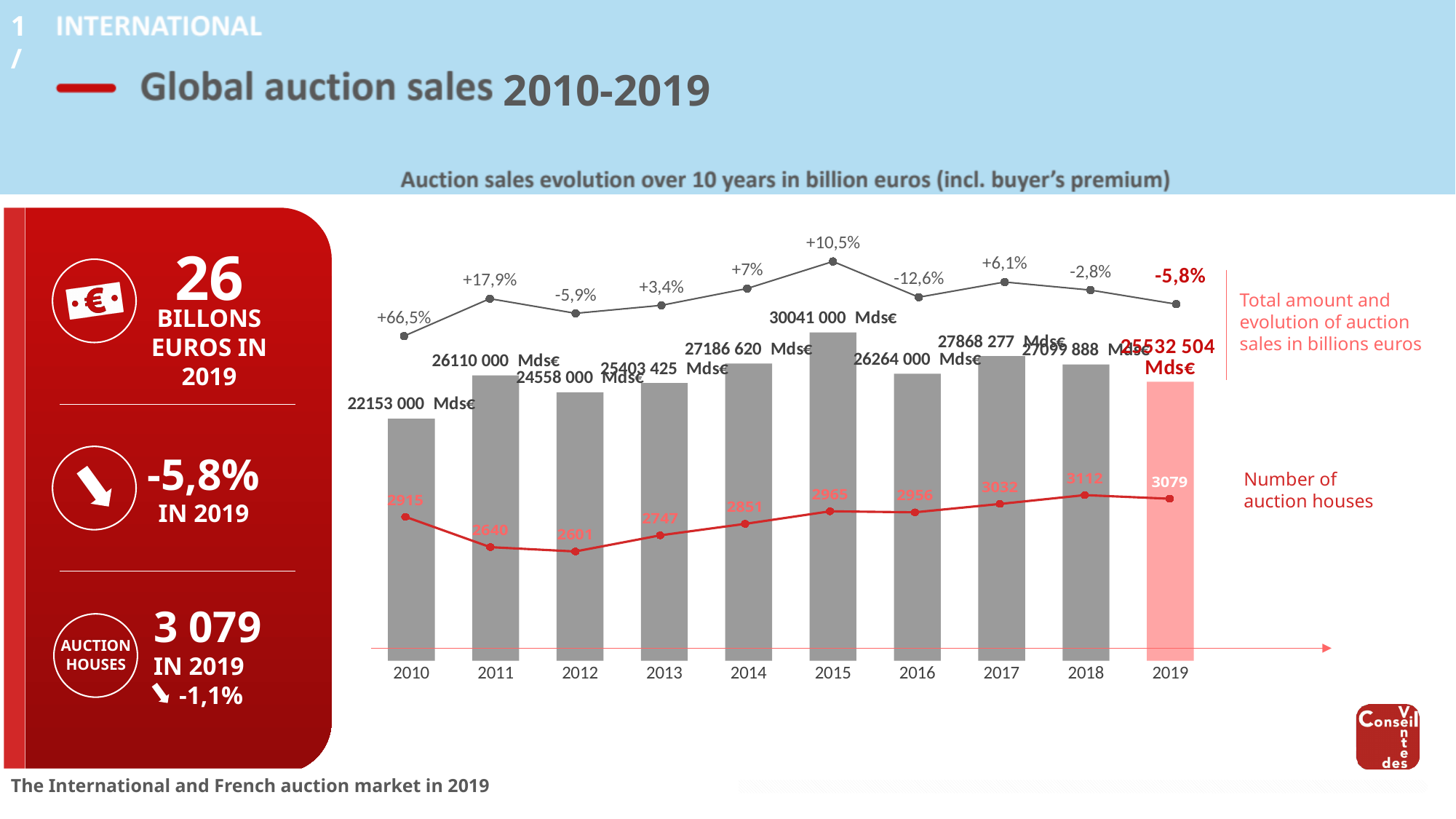
How many auction houses are shown for 2018? 3112 Which year has the lowest total auction sales bar? 2010 What kind of chart is used to show the total auction sales amounts? bar chart Does the number of auction houses rise or fall from 2012 to 2018? rise Which year has the larger total auction sales, 2011 or 2012? 2011 Which year has the highest total auction sales bar? 2015 How many years are shown on the x axis? 10 What is the difference in the number of auction houses between 2018 and 2019? 33 Which year has the lowest number of auction houses? 2012 What is the total auction sales value shown for 2015? 30041 000 Mds€ What percentage evolution is shown for 2016? -12,6% What is the total auction sales value shown for 2010? 22153 000 Mds€